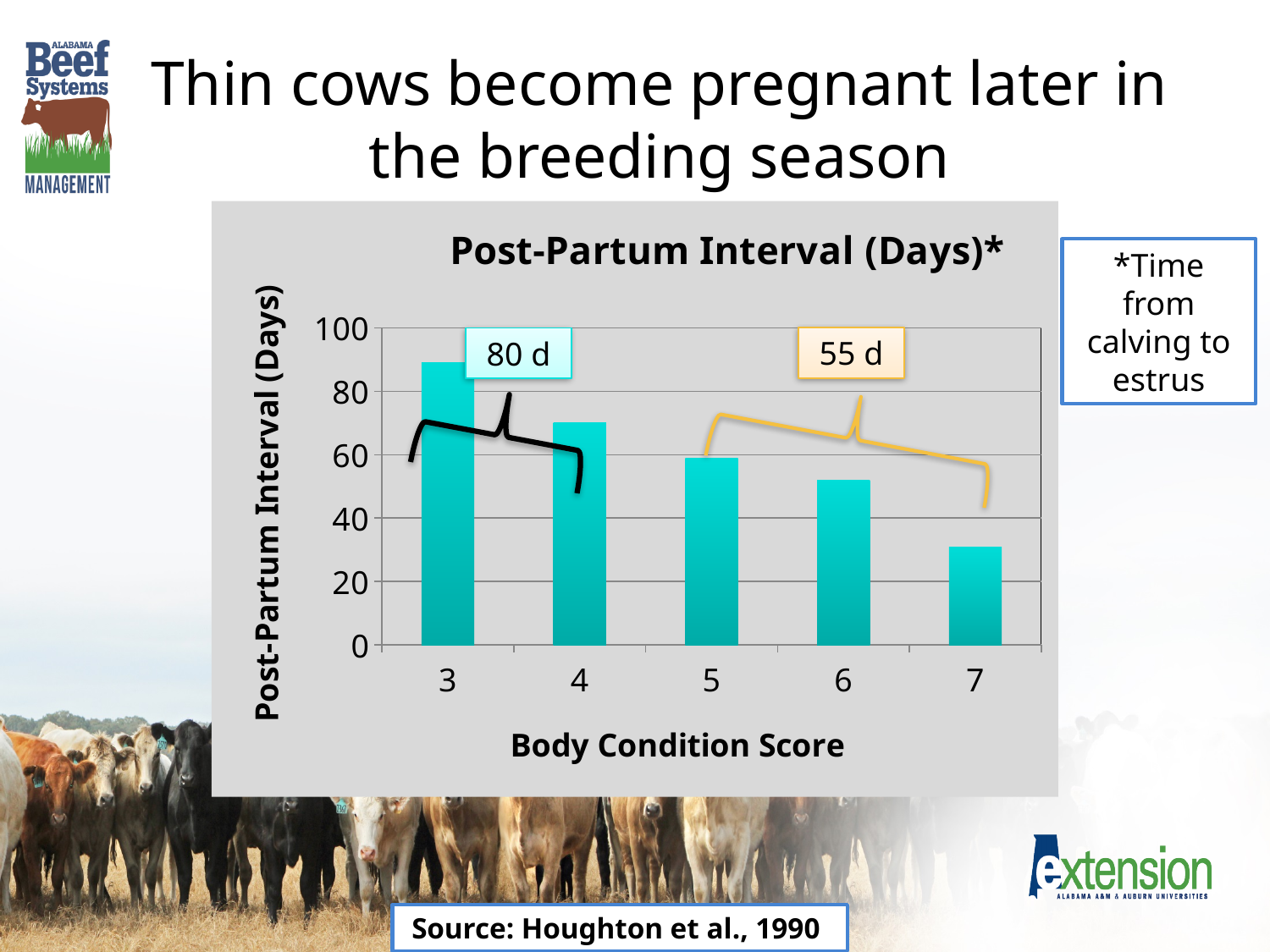
What is the label of the x axis? Body Condition Score Which body condition score has the highest post-partum interval? 3 Is the post-partum interval for body condition score 3 greater or less than 80? greater What is the title of the chart? Post-Partum Interval (Days)* What kind of chart is shown on the slide? bar chart Do the post-partum interval values rise or fall as body condition score increases from 3 to 7? fall How many body condition score categories are plotted? 5 Is the post-partum interval for body condition score 6 greater or less than 40? greater Is the post-partum interval for body condition score 7 greater or less than 40? less Which body condition score has the lowest post-partum interval? 7 Which has a larger post-partum interval, body condition score 4 or body condition score 6? 4